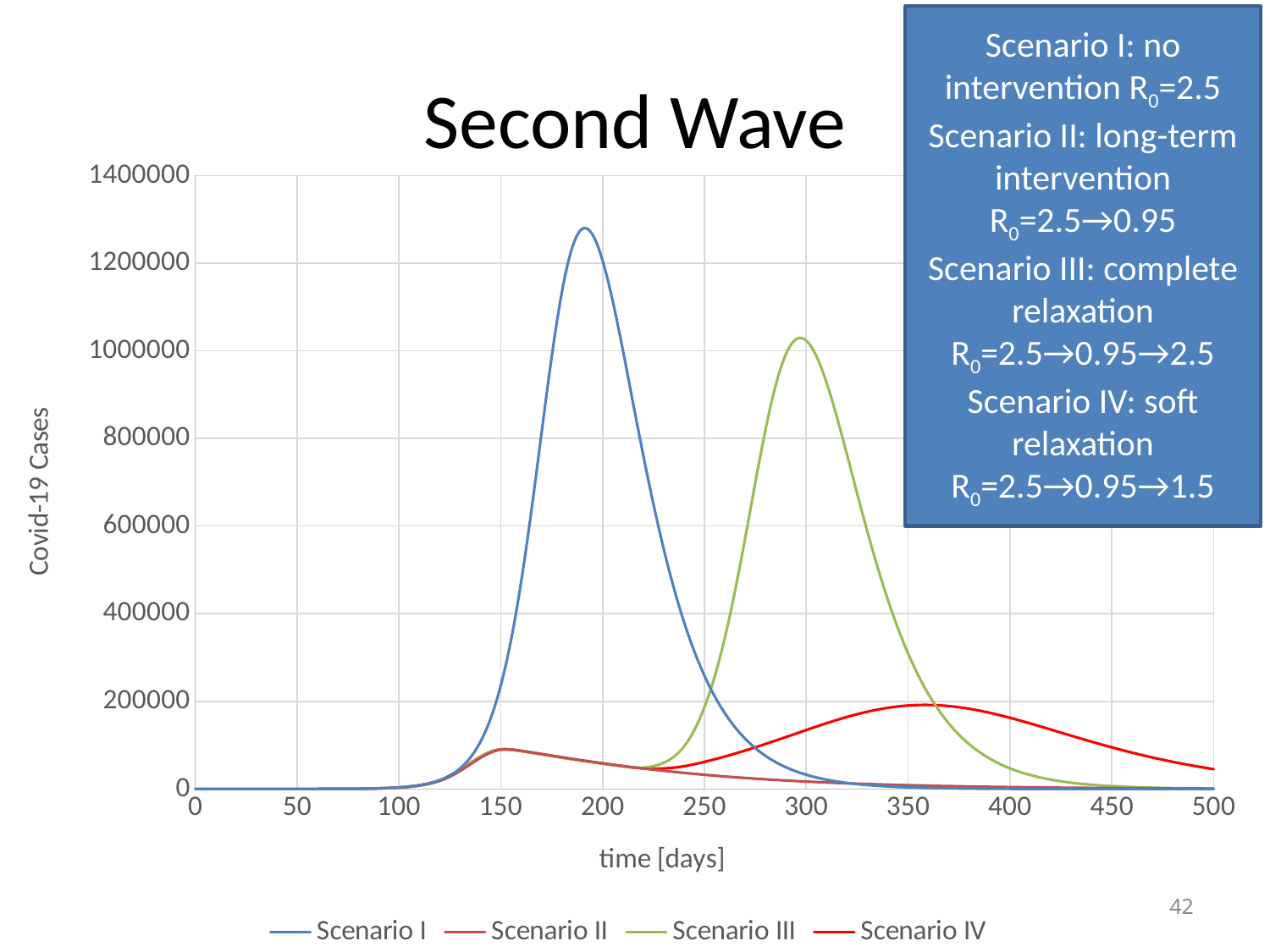
Is the peak value for Scenario I greater or less than 1200000? greater Which scenario reaches the highest peak number of Covid-19 cases? Scenario I Does the Scenario I curve rise or fall between day 200 and day 300? fall How many series does the legend list? 4 What is the title of the chart? Second Wave Is the peak value for Scenario III greater or less than 800000? greater What kind of chart is shown on the slide? line chart Which scenario has the lowest peak number of Covid-19 cases? Scenario II Is the peak value for Scenario II greater or less than 200000? less What is the label of the x axis? time [days] Which has a higher peak, Scenario III or Scenario IV? Scenario III